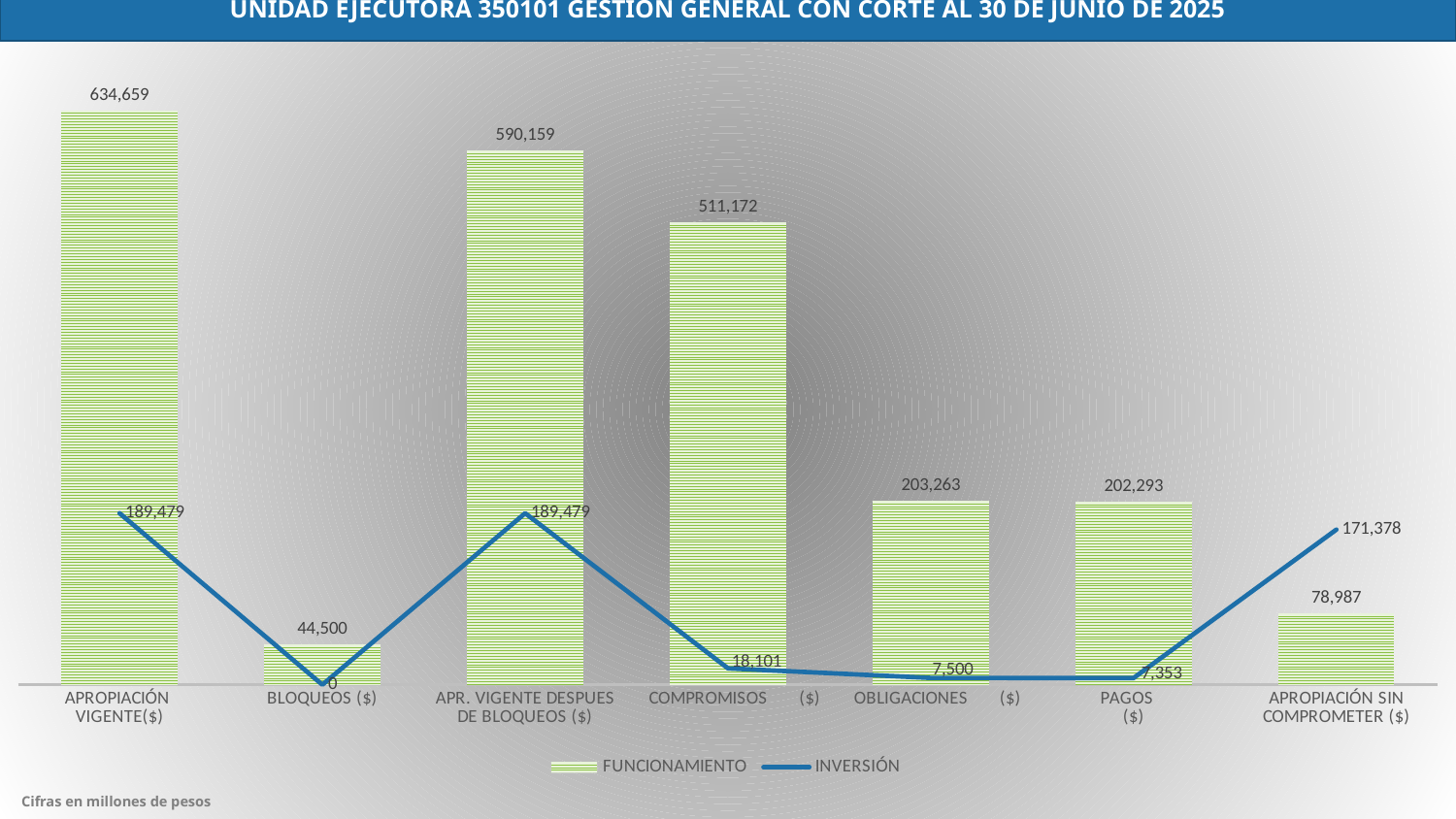
What is the INVERSIÓN value for APROPIACIÓN SIN COMPROMETER ($)? 171,378 Which series is drawn as a line? INVERSIÓN How many categories are shown on the x axis? 7 How many series does the legend list? 2 Which is larger, the INVERSIÓN value for OBLIGACIONES ($) or for PAGOS ($)? OBLIGACIONES ($) What is the INVERSIÓN value for BLOQUEOS ($)? 0 What is the FUNCIONAMIENTO value for APROPIACIÓN VIGENTE($)? 634,659 What is the FUNCIONAMIENTO value for COMPROMISOS ($)? 511,172 What is the difference between the FUNCIONAMIENTO values for APROPIACIÓN VIGENTE($) and APR. VIGENTE DESPUES DE BLOQUEOS ($)? 44,500 What kind of chart is shown on the slide? Combined bar and line chart Which category has the lowest FUNCIONAMIENTO value? BLOQUEOS ($) Which category has the highest FUNCIONAMIENTO value? APROPIACIÓN VIGENTE($)